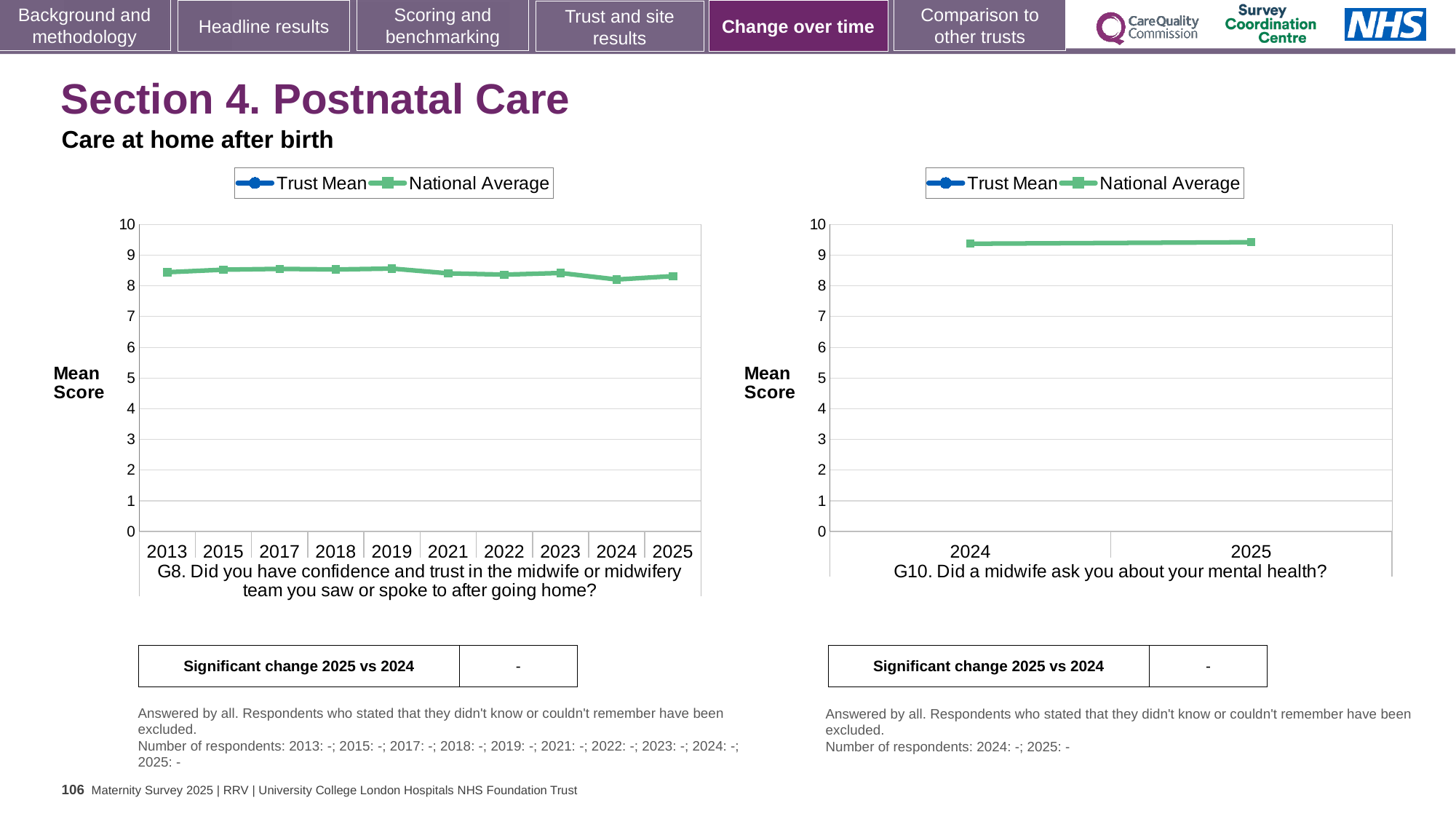
In the left chart (G8), is the National Average value for 2024 greater or less than 8? greater In the left chart (G8), is the National Average value for 2019 greater or less than 9? less How many series does the legend of the right chart (G10) list? 2 In the right chart (G10), is the National Average value for 2025 greater or less than 9? greater What type of chart is the left chart (G8)? line chart How many years are shown on the x axis of the left chart (G8)? 10 How many years are shown on the x axis of the right chart (G10)? 2 What is the y-axis label on the left chart (G8)? Mean Score How many series does the legend of the left chart (G8) list? 2 What type of chart is the right chart (G10)? line chart